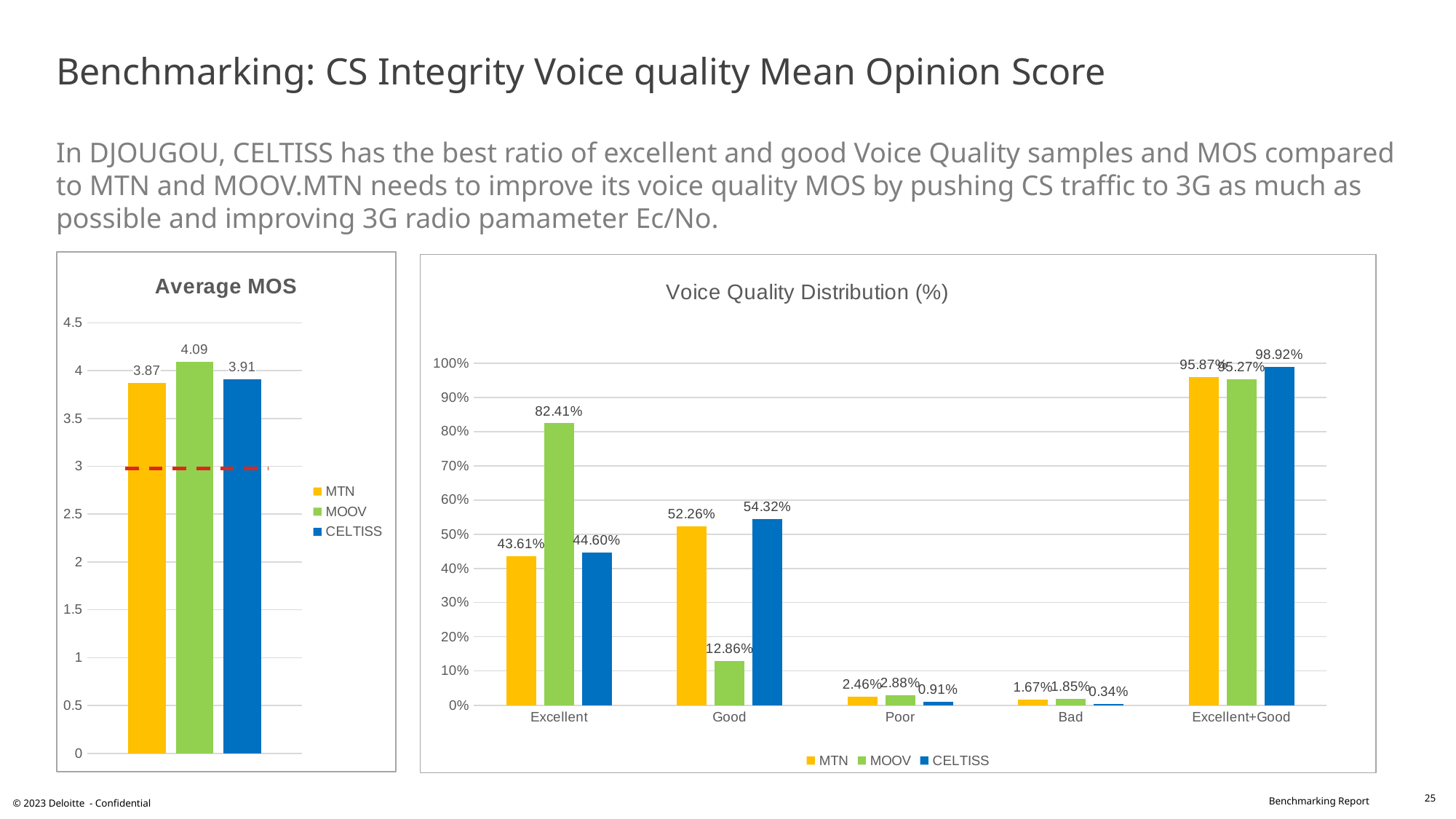
In the Average MOS chart, how many series does the legend list? 3 In the Average MOS chart, what is the value for MOOV? 4.09 In the Voice Quality Distribution (%) chart, what is the value for CELTISS in the Good category? 54.32% In the Voice Quality Distribution (%) chart, what is the value for MOOV in the Excellent category? 82.41% In the Voice Quality Distribution (%) chart, what is the difference between MTN's and MOOV's values in the Excellent category? 38.80% In the Voice Quality Distribution (%) chart, which is larger in the Good category: MTN or MOOV? MTN In the Voice Quality Distribution (%) chart, which operator has the highest value in the Excellent+Good category? CELTISS What kind of chart is the Voice Quality Distribution (%) chart? Bar chart In the Average MOS chart, what is the difference between MOOV's and MTN's values? 0.22 In the Voice Quality Distribution (%) chart, what is the value for CELTISS in the Bad category? 0.34% In the Voice Quality Distribution (%) chart, how many categories are shown on the x axis? 5 In the Average MOS chart, which operator has the lowest average MOS? MTN